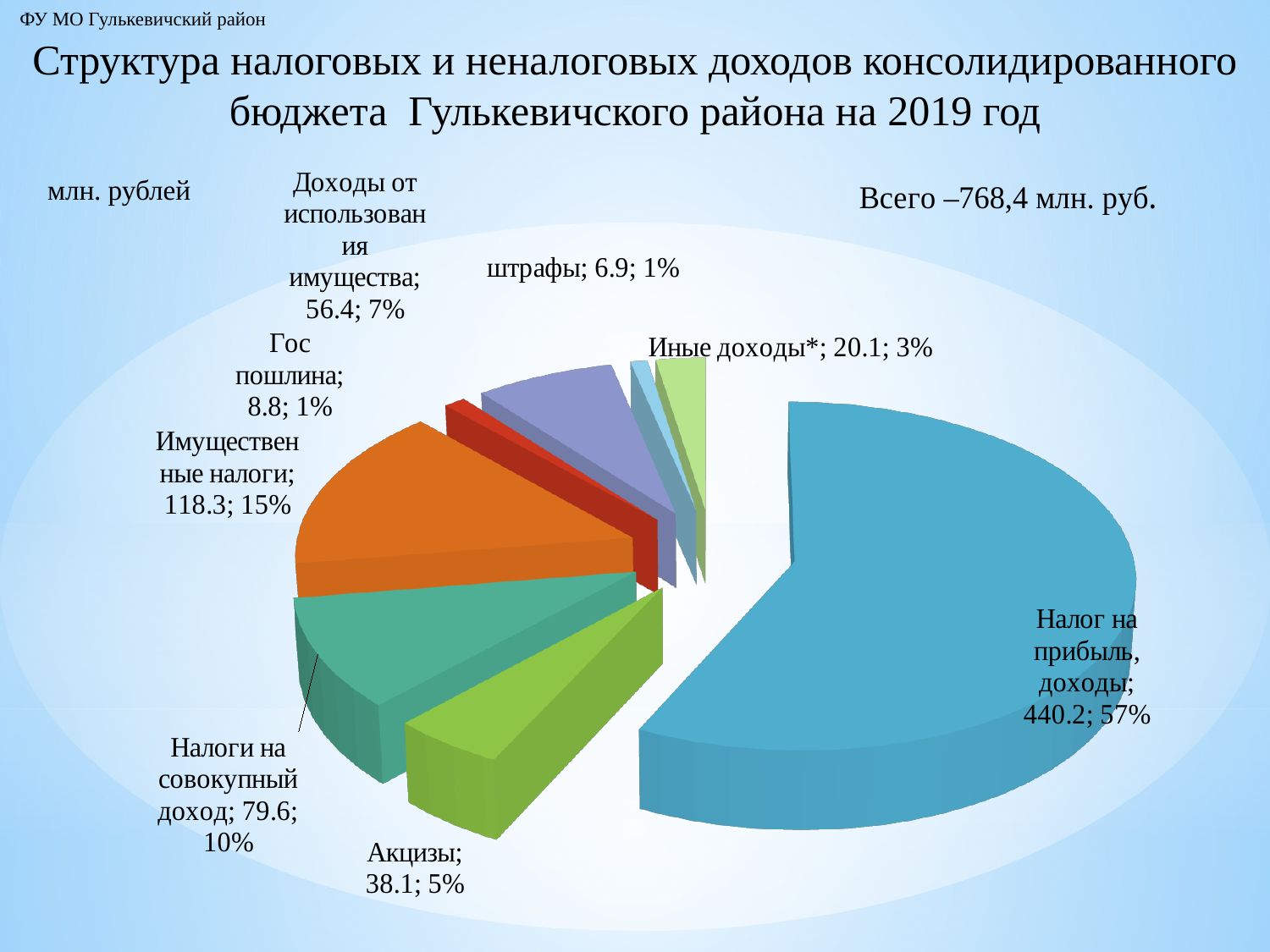
How many slices does the pie chart have? 8 What share of the pie does Налоги на совокупный доход take? 10% What share of the pie does Имущественные налоги take? 15% What is the value for Акцизы? 38.1 Which category has the smallest slice? штрафы What is the difference between the values for Имущественные налоги and Налоги на совокупный доход? 38.7 What kind of chart is shown on the slide? pie chart What is the value for Налог на прибыль, доходы? 440.2 Which is larger, Доходы от использования имущества or Иные доходы*? Доходы от использования имущества What is the value for Гос пошлина? 8.8 What total is stated on the slide for all revenues? 768,4 млн. руб. Which category has the largest slice? Налог на прибыль, доходы